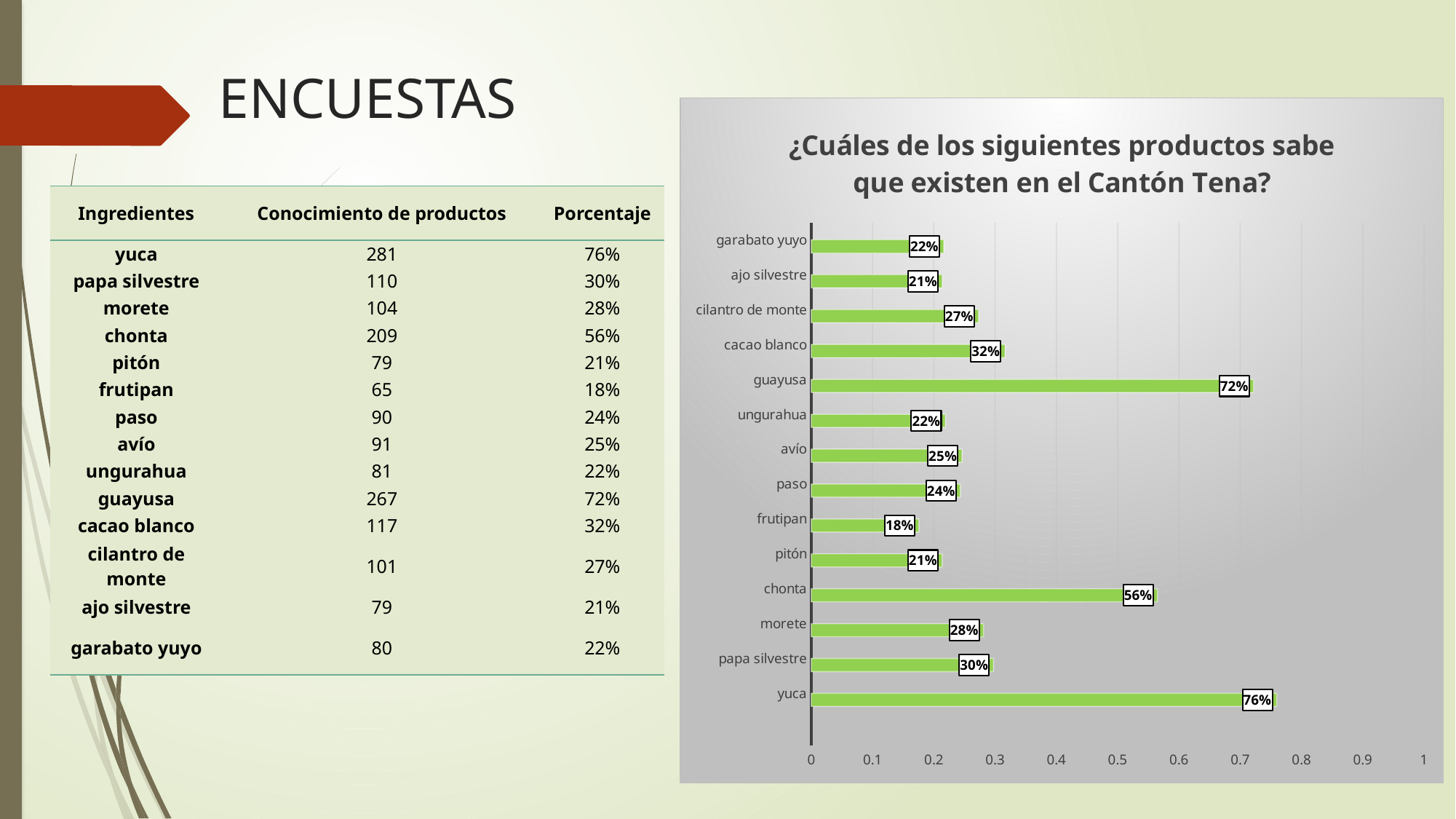
What is the title of the chart? ¿Cuáles de los siguientes productos sabe que existen en el Cantón Tena? Is the value for chonta greater or less than 0.5 on the axis? greater What kind of chart is shown on the slide? bar chart What is the difference between the values for yuca and guayusa? 4% Which category has the lowest value in the chart? frutipan What is the value for chonta in the chart? 56% Which category has the highest value in the chart? yuca Which is larger, the value for cacao blanco or the value for papa silvestre? cacao blanco What is the value for frutipan in the chart? 18% What is the difference between the values for cacao blanco and cilantro de monte? 5% What is the value for guayusa in the chart? 72% How many categories are shown in the chart? 14